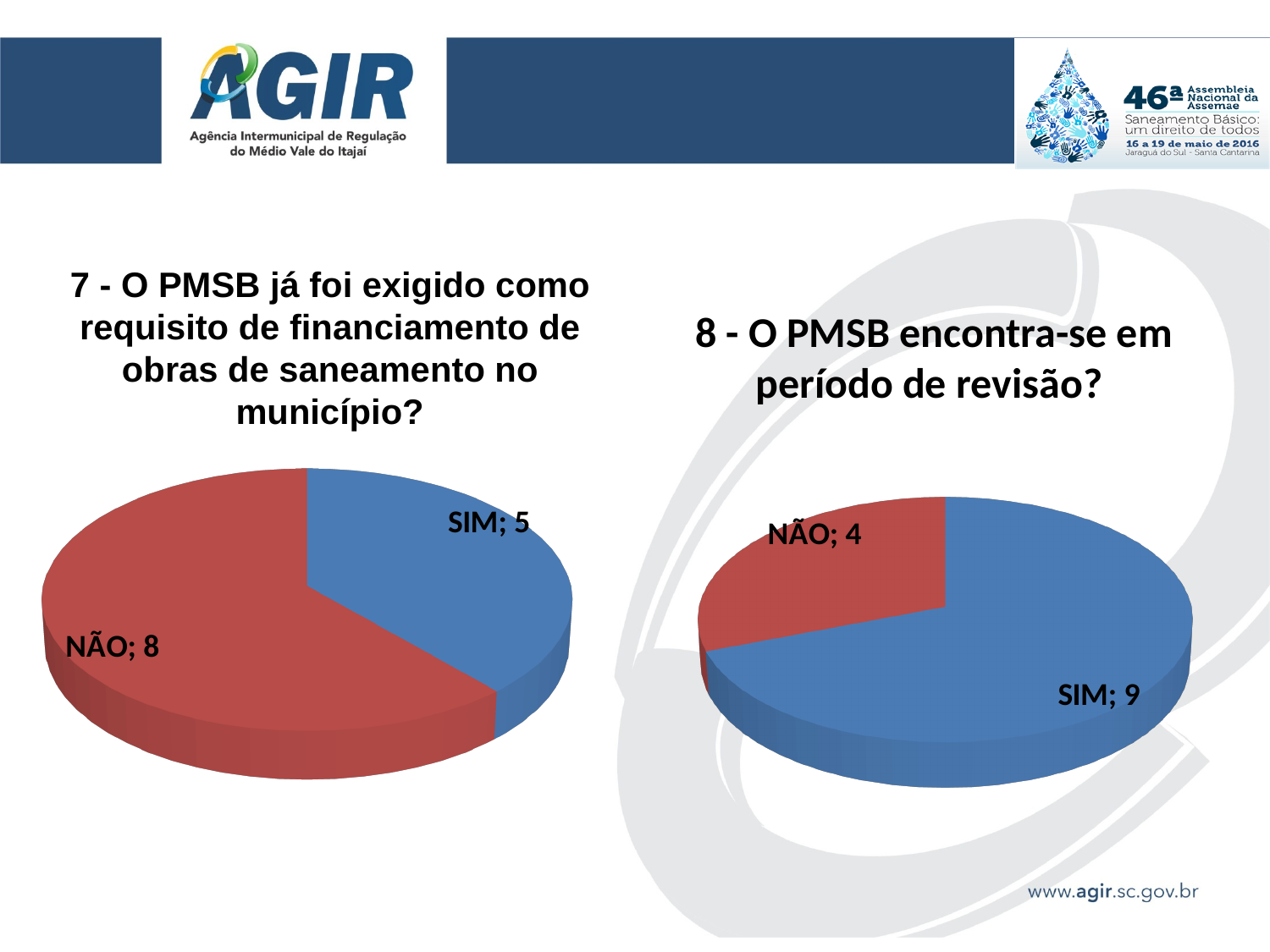
In the left pie chart (question 7), what is the value for NÃO? 8 What type of chart is used for question 8 on the right? Pie chart In the left pie chart (question 7), what is the difference between NÃO and SIM? 3 In the right pie chart (question 8), what is the difference between SIM and NÃO? 5 In the right pie chart (question 8), what colour is the SIM slice? Blue In the left pie chart (question 7), which category has the largest slice? NÃO In the right pie chart (question 8), which category has the smallest slice? NÃO How many slices does the left pie chart (question 7) have? 2 In the right pie chart (question 8), what is the value for SIM? 9 In the right pie chart (question 8), what is the value for NÃO? 4 In the left pie chart (question 7), what is the value for SIM? 5 In the right pie chart (question 8), which is larger, SIM or NÃO? SIM